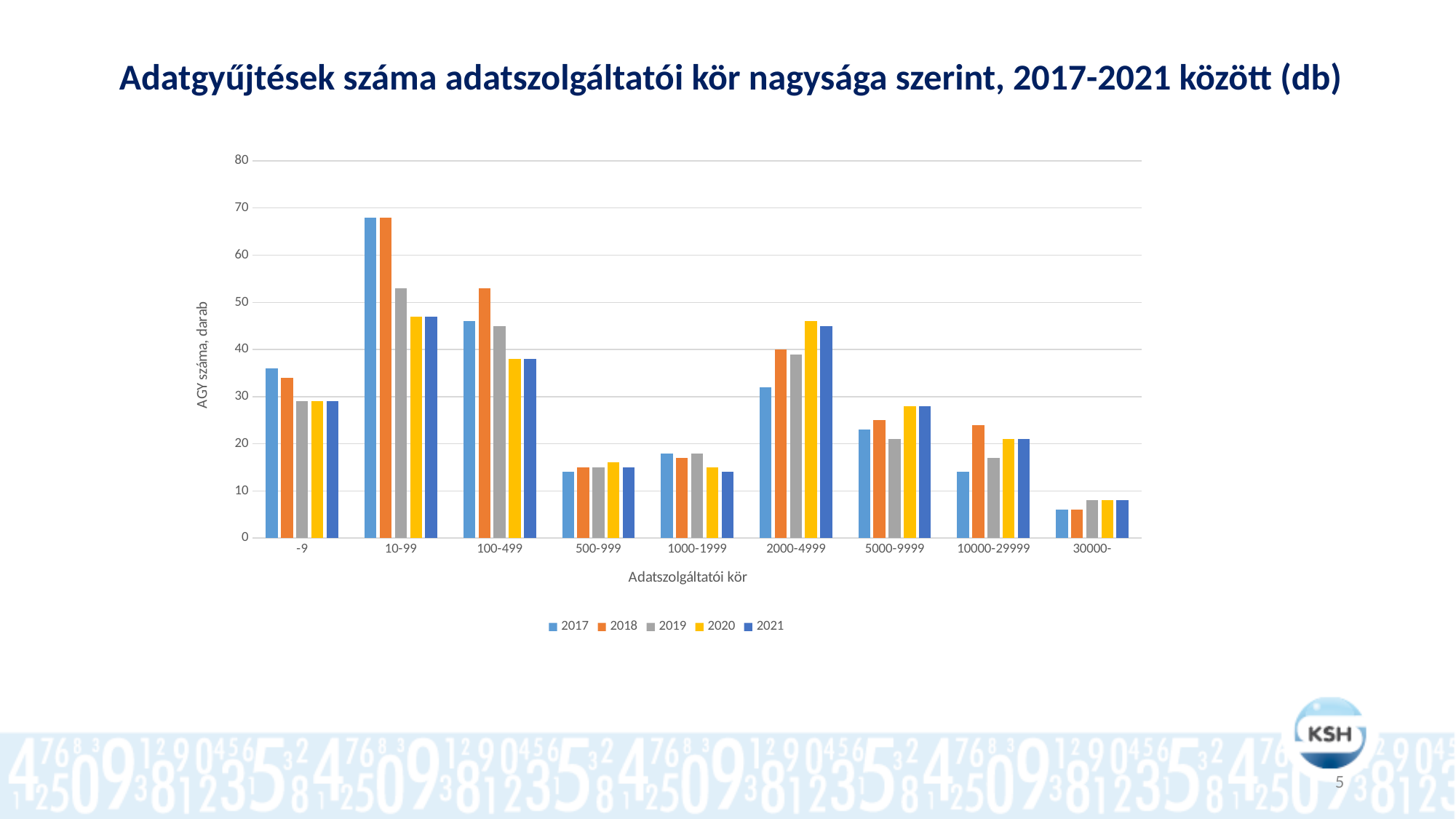
Is the 2017 value for 10-99 greater or less than 60? greater Is the 2017 value for 10000-29999 greater or less than 20? less Which category has the highest value for the 2019 series? 10-99 For the 2000-4999 category, which is larger: the 2020 value or the 2017 value? 2020 Is the 2021 value for 30000- greater or less than 10? less Which category has the lowest value for the 2021 series? 30000- What is the label of the y axis? AGY száma, darab How many series does the legend list? 5 How many categories are shown on the x axis? 9 What kind of chart is shown on the slide? bar chart For the 100-499 category, which is larger: the 2018 value or the 2017 value? 2018